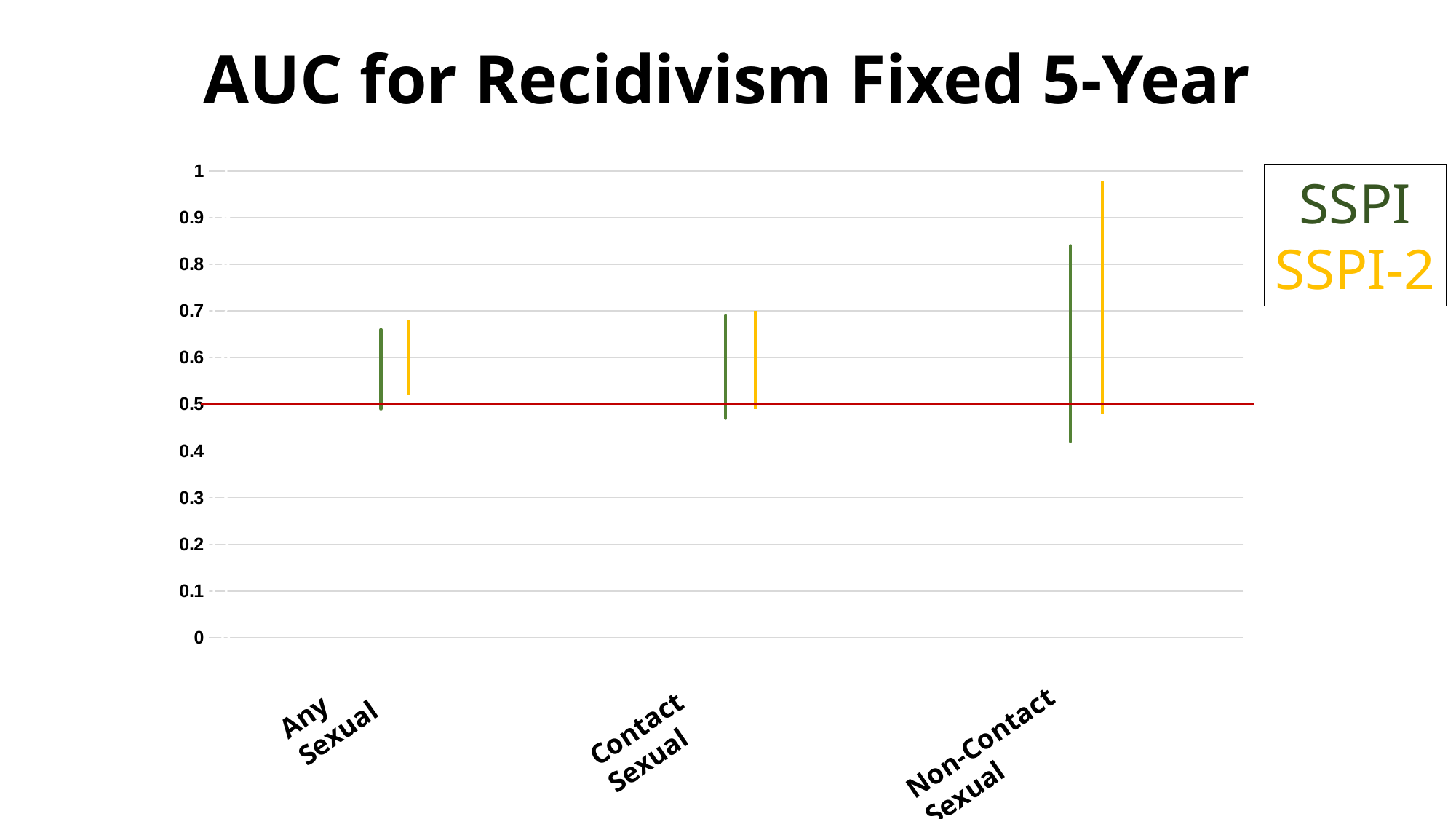
Is the lower end of the SSPI range for Non-Contact Sexual greater or less than 0.5? less Is the lower end of the SSPI range for Contact Sexual greater or less than 0.5? less How many series does the legend list? 2 Is the upper end of the SSPI-2 range for Non-Contact Sexual greater or less than 0.9? greater How many categories are shown on the x axis? 3 Which category has the highest upper end for the SSPI-2 series? Non-Contact Sexual Which series is shown in yellow in the legend? SSPI-2 Which category has the widest SSPI range? Non-Contact Sexual What is the title of the chart? AUC for Recidivism Fixed 5-Year